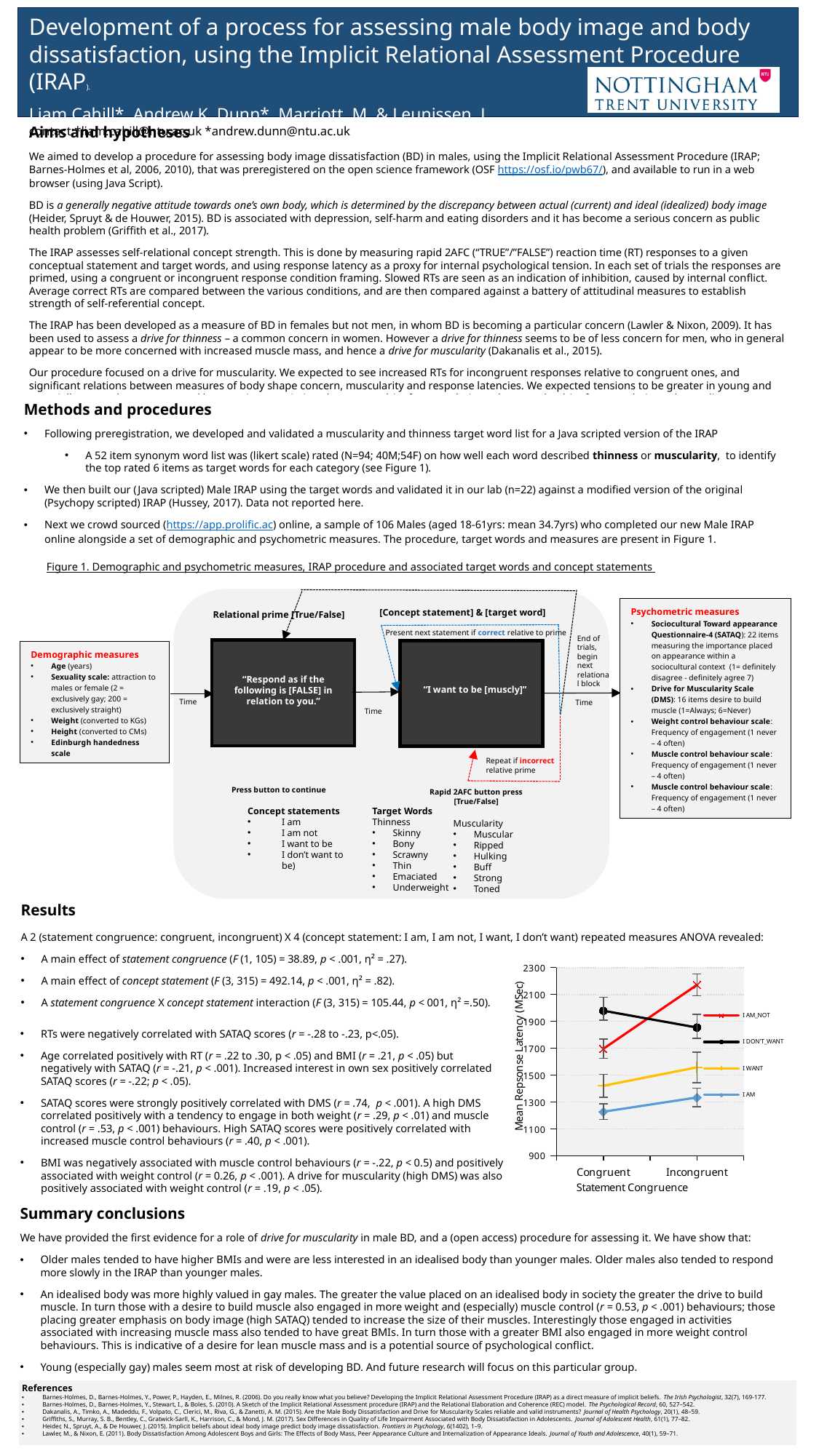
In the Results chart, is the value for I AM_NOT at Incongruent greater or less than 2100? greater What kind of chart is shown in the Results section? line chart In the Results chart, which series has the highest value at Incongruent? I AM_NOT What is the title of the x axis of the Results chart? Statement Congruence In the Results chart, which series has the lowest value at Congruent? I AM What is the title of the y axis of the Results chart? Mean Response Latency (MSec) In the Results chart, which series has the highest value at Congruent? I DON'T_WANT How many categories are shown on the x axis of the Results chart? 2 How many series does the legend of the Results chart list? 4 In the Results chart, is the value for I AM at Congruent greater or less than 1300? less In the Results chart, does the I DON'T_WANT series rise or fall from Congruent to Incongruent? fall In the Results chart, does the I AM_NOT series rise or fall from Congruent to Incongruent? rise